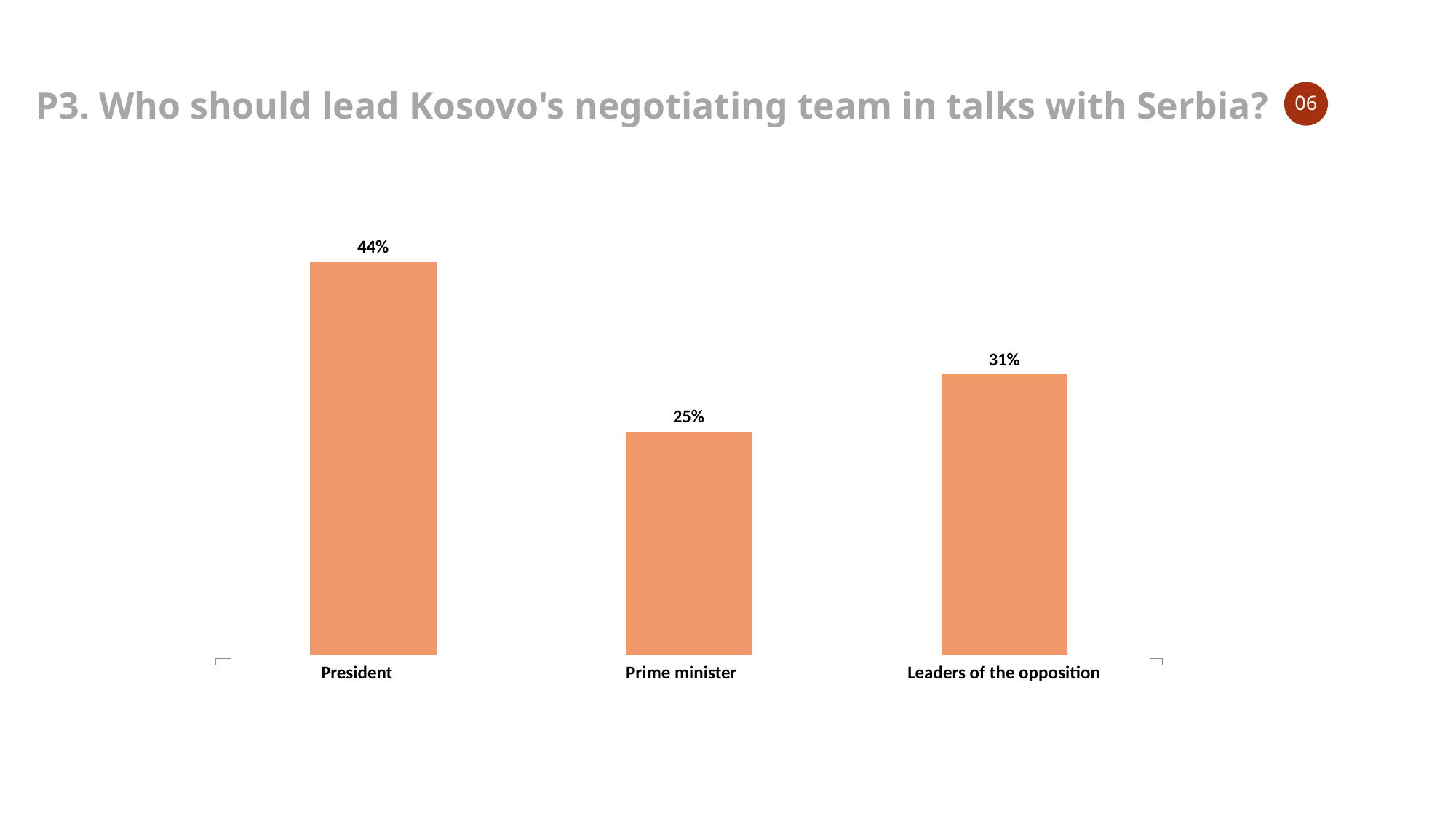
What is the difference between the values for Leaders of the opposition and Prime minister? 6% How many categories are shown in the chart? 3 What percentage of respondents said the President should lead Kosovo's negotiating team? 44% What is the difference between the values for President and Prime minister? 19% Which category has the highest value? President Which is larger, the value for Leaders of the opposition or the value for Prime minister? Leaders of the opposition What is the total of the three values shown in the chart? 100% What is the value shown for Prime minister? 25% What is the value shown for Leaders of the opposition? 31% Which category has the lowest value? Prime minister What kind of chart is shown on the slide? Bar chart What is the title of the slide? P3. Who should lead Kosovo's negotiating team in talks with Serbia?